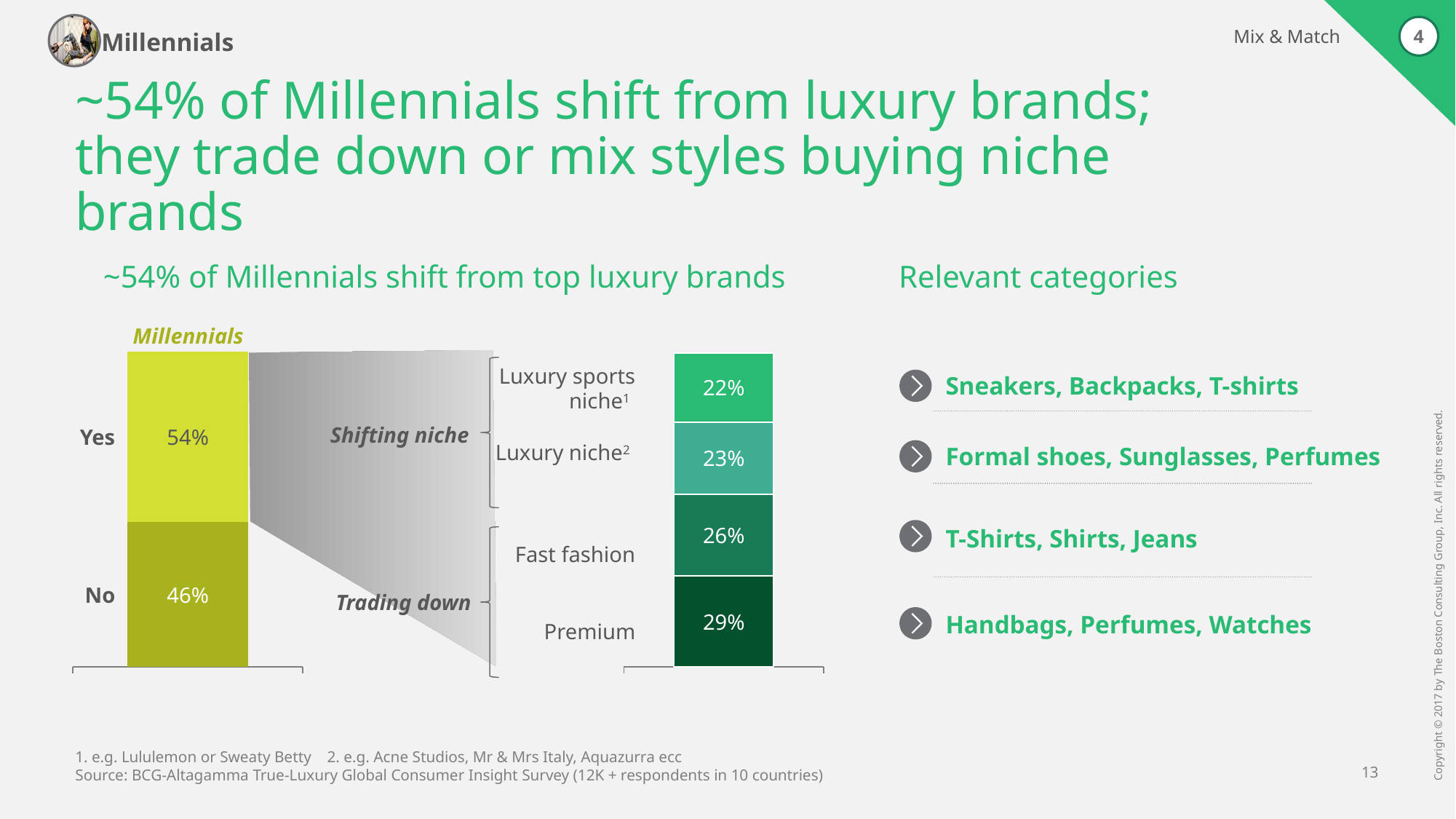
In the right stacked bar, what share goes to Fast fashion? 26% In the right stacked bar, which segment has the smallest share? Luxury sports niche How many segments make up the right stacked bar? 4 In the right stacked bar, what share goes to Premium? 29% In the left 'Millennials' bar, what is the difference between the Yes and No percentages? 8% In the right stacked bar, which is larger: Luxury niche or Fast fashion? Fast fashion In the right stacked bar, which segment has the largest share? Premium In the left 'Millennials' bar, what percentage answered No? 46% In the right stacked bar, what is the difference between the Premium share and the Luxury sports niche share? 7% What type of chart is used on the left to show the Yes/No split for Millennials? Stacked bar chart In the left 'Millennials' bar, what percentage of Millennials answered Yes to shifting from top luxury brands? 54% In the right stacked bar, what share goes to Luxury sports niche? 22%